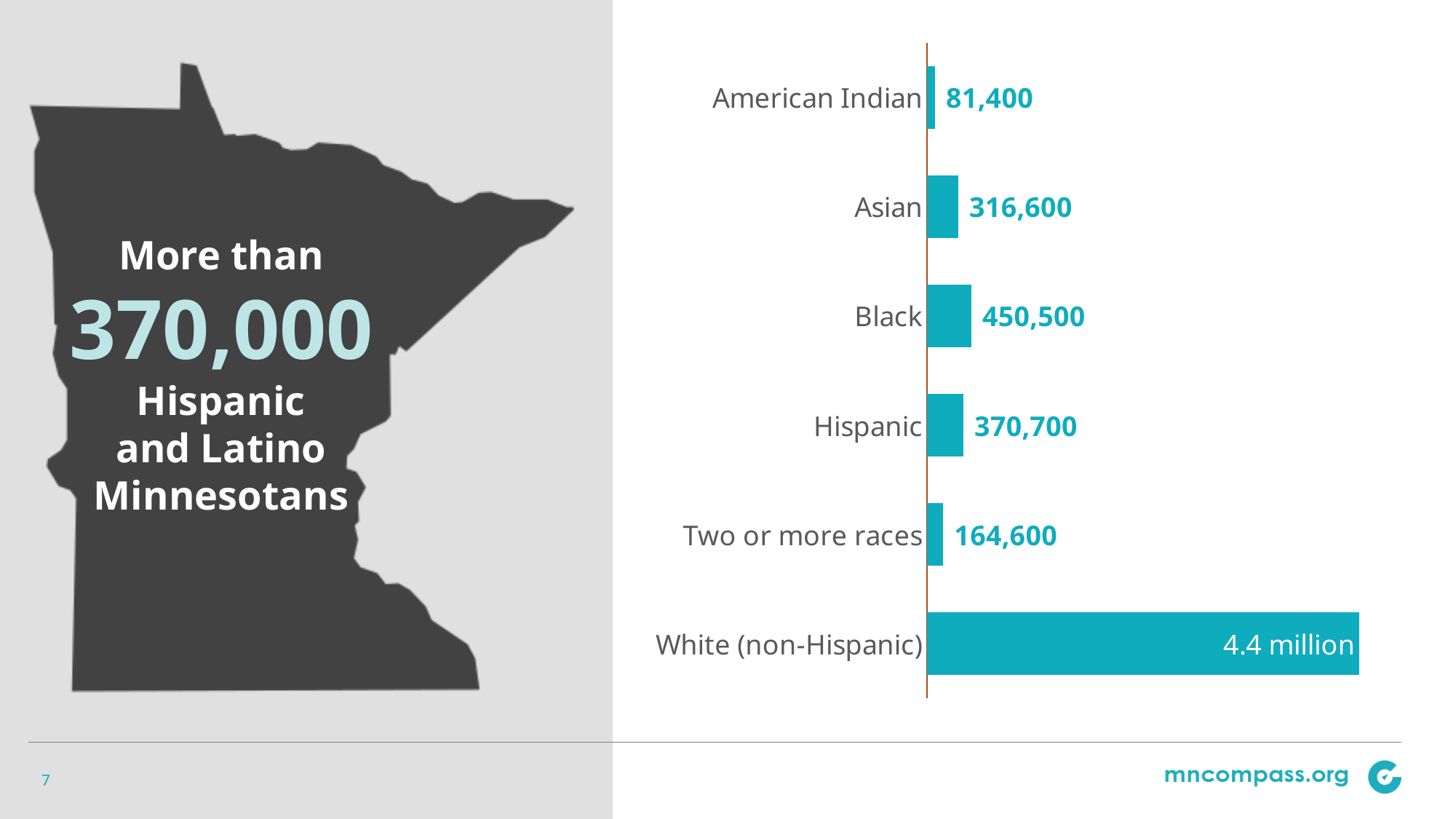
Which category has the lowest value? American Indian What is the difference between the values for Black and Hispanic? 79,800 Which category has the highest value? White (non-Hispanic) How many categories are shown in the chart? 6 What is the value shown for American Indian? 81,400 Which is larger, the value for Black or the value for Asian? Black What is the value shown for Hispanic? 370,700 What is the difference between the values for Asian and Two or more races? 152,000 What is the value shown for White (non-Hispanic)? 4.4 million What is the value shown for Two or more races? 164,600 What is the value shown for Asian? 316,600 What kind of chart is shown on the slide? bar chart